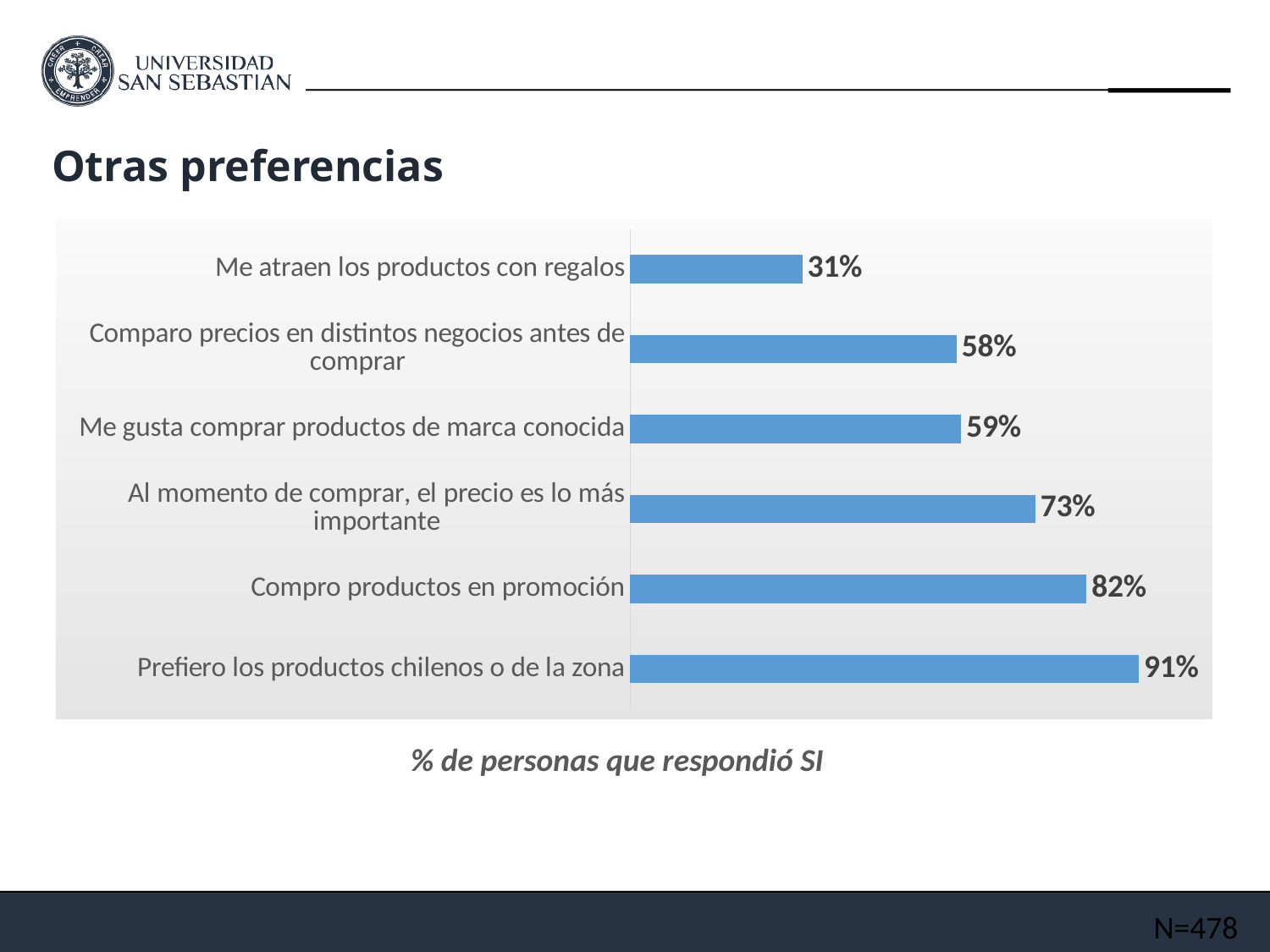
What is the difference between the values for "Compro productos en promoción" and "Me atraen los productos con regalos"? 51% What is the value shown for "Me atraen los productos con regalos"? 31% What is the difference between "Prefiero los productos chilenos o de la zona" and "Al momento de comprar, el precio es lo más importante"? 18% Which category has the highest percentage? Prefiero los productos chilenos o de la zona What is the value for "Al momento de comprar, el precio es lo más importante"? 73% What kind of chart is shown on the slide? Bar chart Which category has the lowest percentage? Me atraen los productos con regalos What percentage of people answered yes to "Prefiero los productos chilenos o de la zona"? 91% Which is larger: the value for "Comparo precios en distintos negocios antes de comprar" or for "Compro productos en promoción"? Compro productos en promoción What percentage is shown for "Compro productos en promoción"? 82% What is the title of the slide containing the chart? Otras preferencias How many categories are shown in the chart? 6